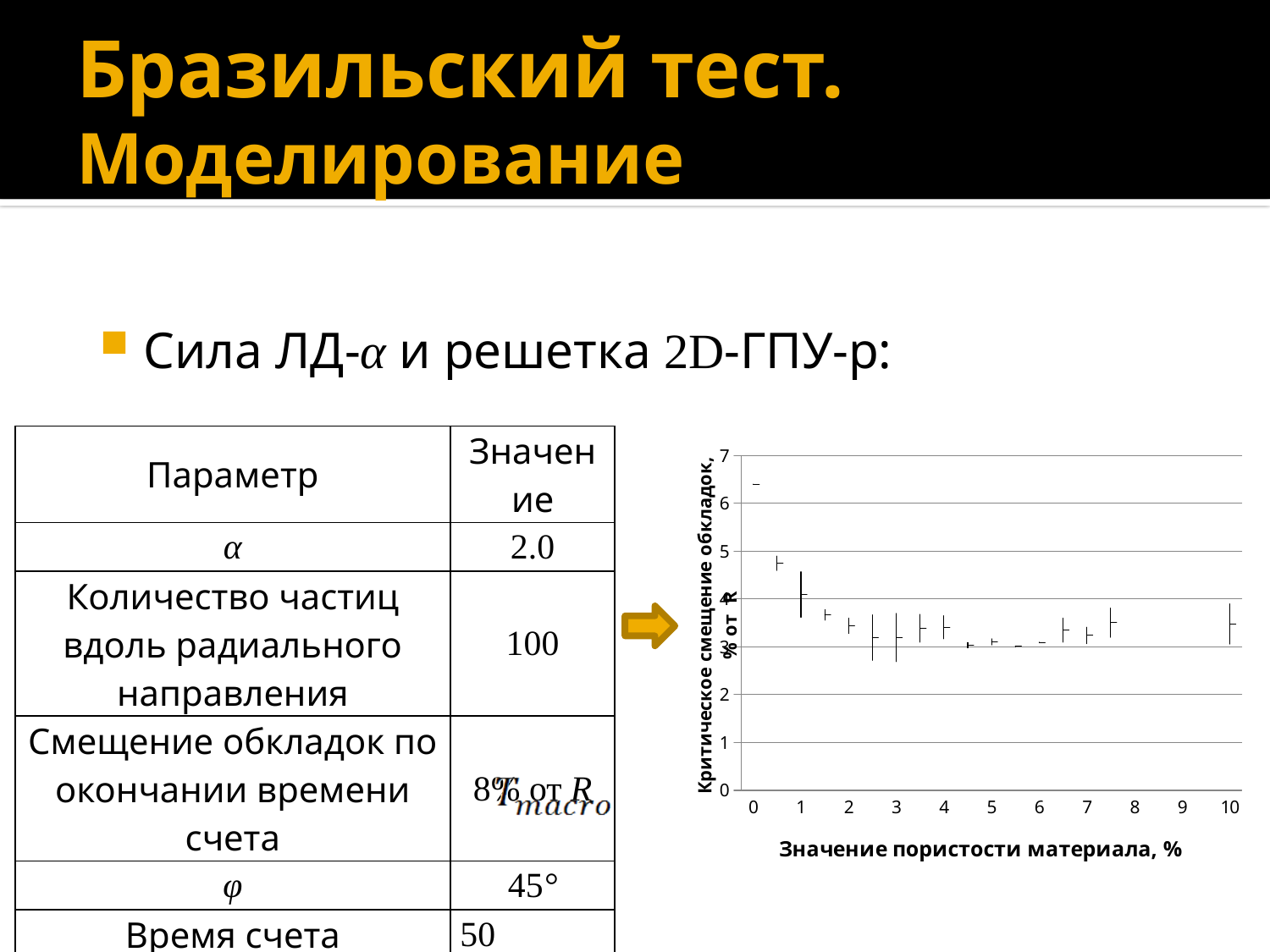
Do the values generally rise or fall as porosity increases from 0 to 5? fall Is the value at porosity 0 greater or less than 6? greater Is the value at porosity 5 greater or less than 4? less What is the title of the vertical axis of the chart? Критическое смещение обкладок, % от R What is the title of the horizontal axis of the chart? Значение пористости материала, % What kind of chart is shown on the right of the slide? stock (high-low-close) chart What is the maximum value shown on the vertical axis of the chart? 7 At which porosity value is the critical displacement highest? 0 Is the value at porosity 2 greater or less than 4? less Which is larger: the value at porosity 0 or the value at porosity 10? porosity 0